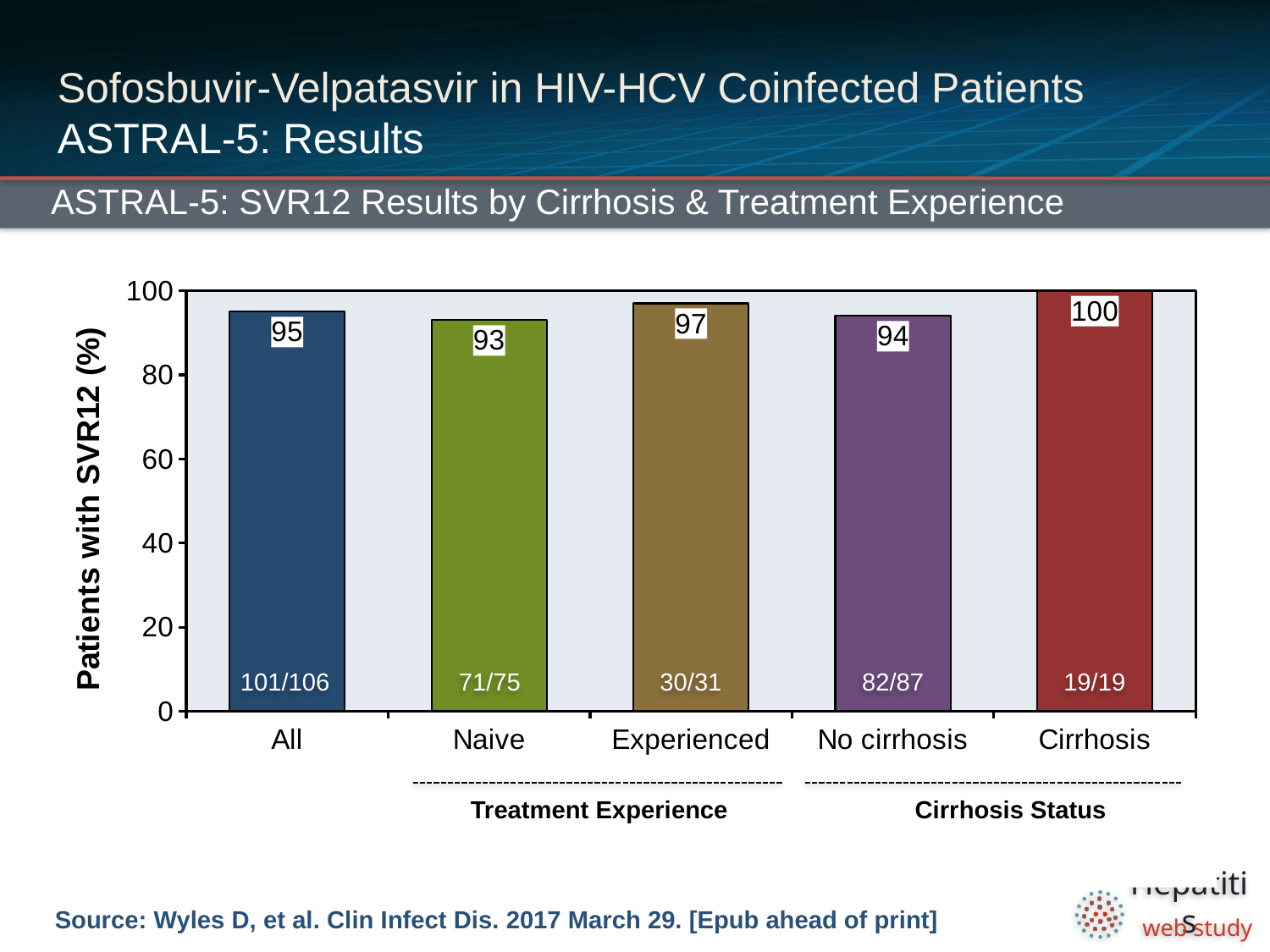
What is the label of the y axis? Patients with SVR12 (%) Which category has the lowest SVR12 rate? Naive What is the SVR12 rate for the All group? 95 What kind of chart is shown on the slide? Bar chart Is the SVR12 rate for No cirrhosis greater or less than 80? greater Which has a higher SVR12 rate, Experienced or Naive? Experienced What fraction of patients is shown inside the Experienced bar? 30/31 What is the SVR12 rate for the Cirrhosis group? 100 What is the difference in SVR12 rate between the Cirrhosis and No cirrhosis groups? 6 Which category has the highest SVR12 rate? Cirrhosis What is the SVR12 rate for the Naive group? 93 How many categories are shown on the x axis? 5